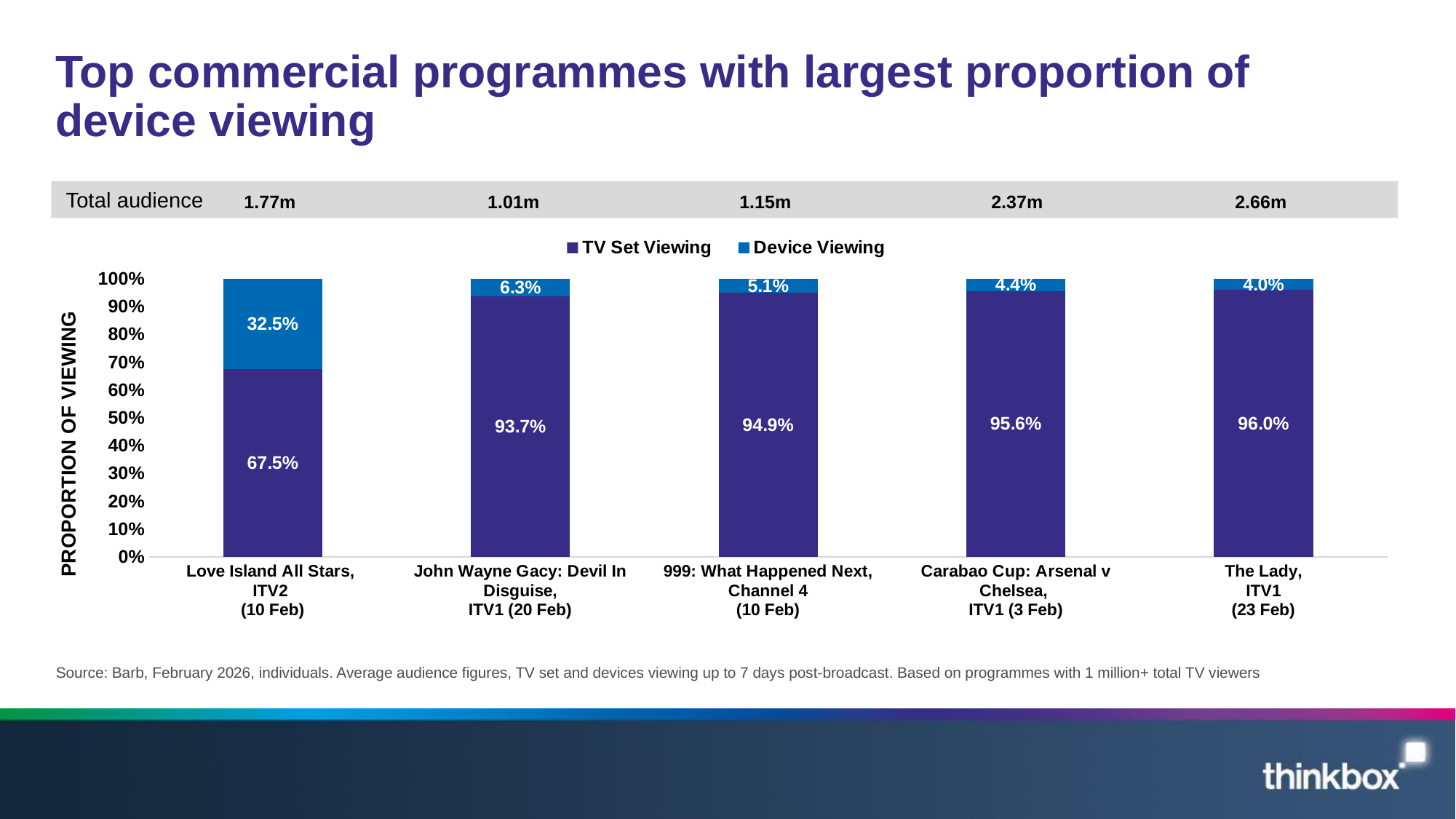
What kind of chart is shown on the slide? Stacked bar chart What is the difference between the TV Set Viewing proportions of The Lady, ITV1 (23 Feb) and Love Island All Stars, ITV2 (10 Feb)? 28.5% What is the Device Viewing proportion for Carabao Cup: Arsenal v Chelsea, ITV1 (3 Feb)? 4.4% How many series does the legend list? 2 What is the TV Set Viewing proportion for The Lady, ITV1 (23 Feb)? 96.0% Which has a larger Device Viewing proportion: John Wayne Gacy: Devil In Disguise or 999: What Happened Next? John Wayne Gacy: Devil In Disguise How many programmes are shown in the chart? 5 Which programme has the lowest Device Viewing proportion? The Lady, ITV1 (23 Feb) What is the Device Viewing proportion for Love Island All Stars, ITV2 (10 Feb)? 32.5% Which programme has the highest Device Viewing proportion? Love Island All Stars, ITV2 (10 Feb) What is the total audience shown for The Lady, ITV1 (23 Feb)? 2.66m What is the TV Set Viewing proportion for John Wayne Gacy: Devil In Disguise, ITV1 (20 Feb)? 93.7%